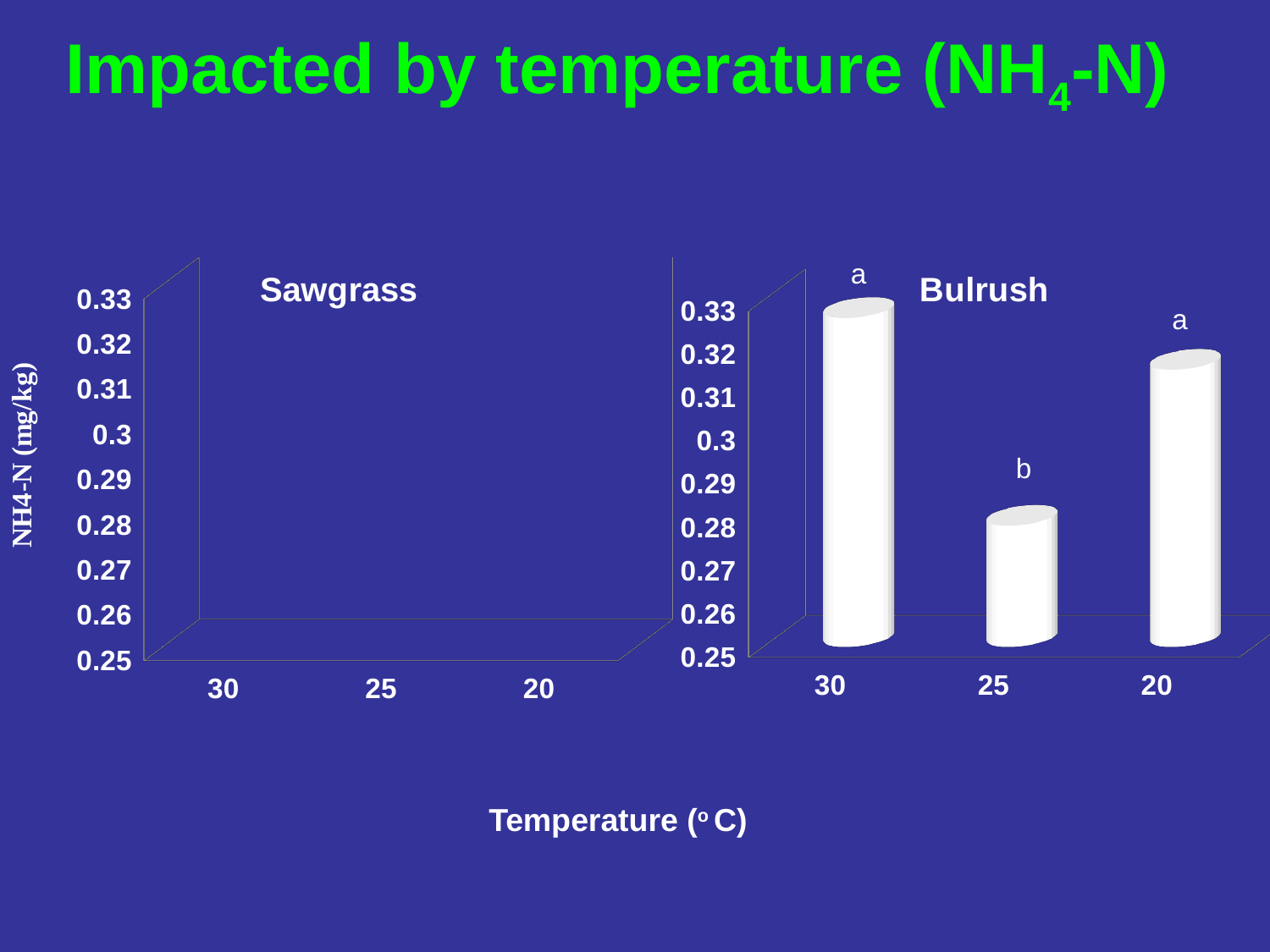
In the Bulrush chart, which temperature has the highest NH4-N value? 30 In the Bulrush chart, which is larger, the value at 30 °C or at 25 °C? 30 °C In the Bulrush chart, which is larger, the value at 20 °C or at 25 °C? 20 °C What is the y-axis label shared by the charts on the slide? NH4-N (mg/kg) In the Bulrush chart, is the value at 25 °C greater or less than 0.29? less In the Bulrush chart, is the value at 30 °C greater or less than 0.3? greater In the Bulrush chart, which temperature has the lowest NH4-N value? 25 What kind of chart is the Bulrush chart? bar chart In the Bulrush chart, is the value at 25 °C greater or less than 0.3? less How many bars are plotted in the Bulrush chart? 3 In the Bulrush chart, what letter is printed above the bar at 25 °C? b